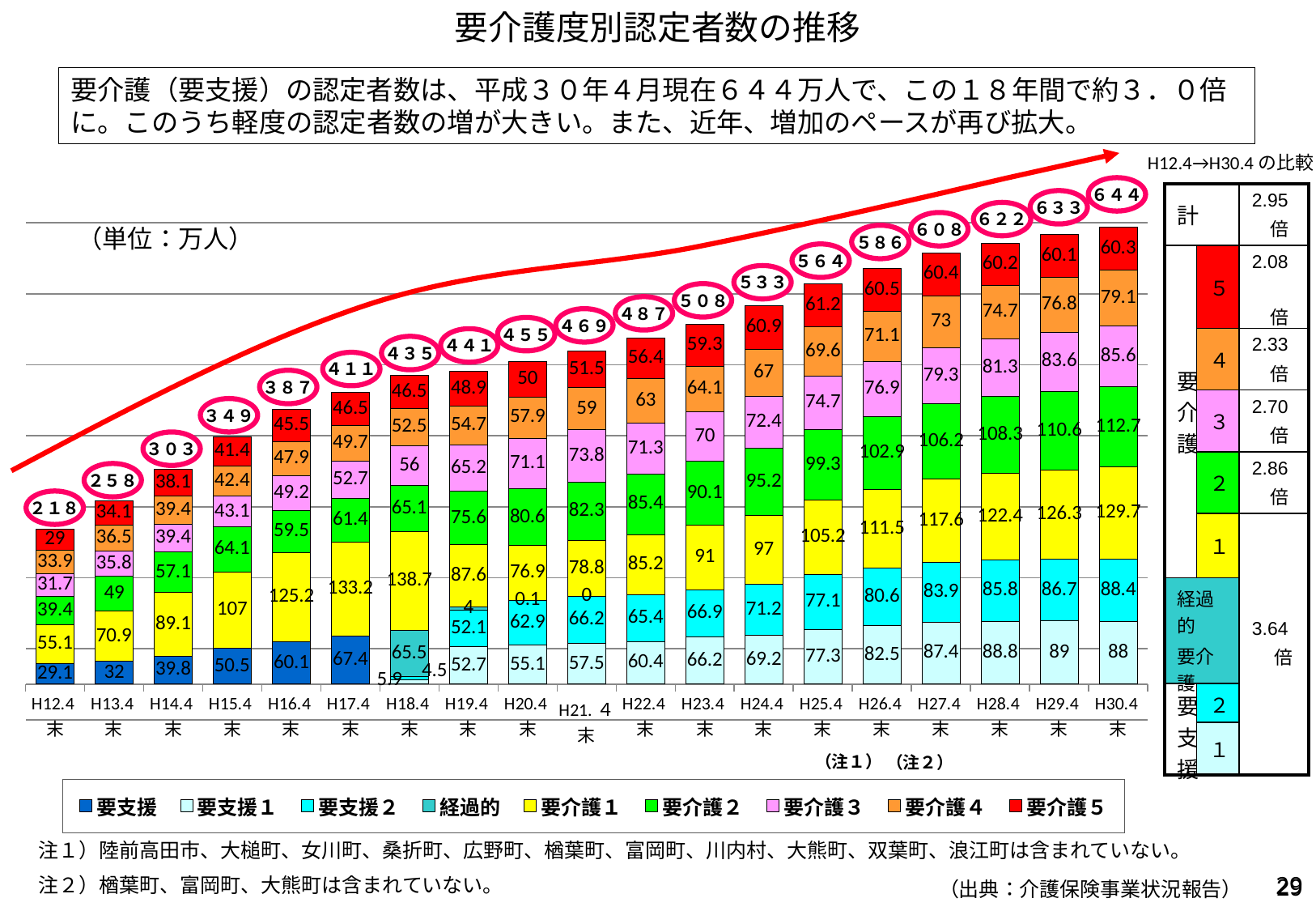
What is the value for 要介護2 at H20.4末? 80.6 What is the value for 要介護1 at H30.4末? 129.7 Do the bar totals rise or fall from H12.4末 to H30.4末? Rise How many time points (bars) are plotted along the x axis? 19 At H30.4末, which is larger: 要介護4 or 要介護5? 要介護4 How many series does the legend list? 9 What kind of chart is shown on the slide? Stacked bar chart Which time point has the lowest total number of certified persons? H12.4末 What is the total (circled value) of the stacked bar for H30.4末? 644 What is the value for 要介護5 at H12.4末? 29 What is the value for 要支援1 at H25.4末? 77.3 What is the difference between the total for H30.4末 (644) and the total for H12.4末 (218)? 426